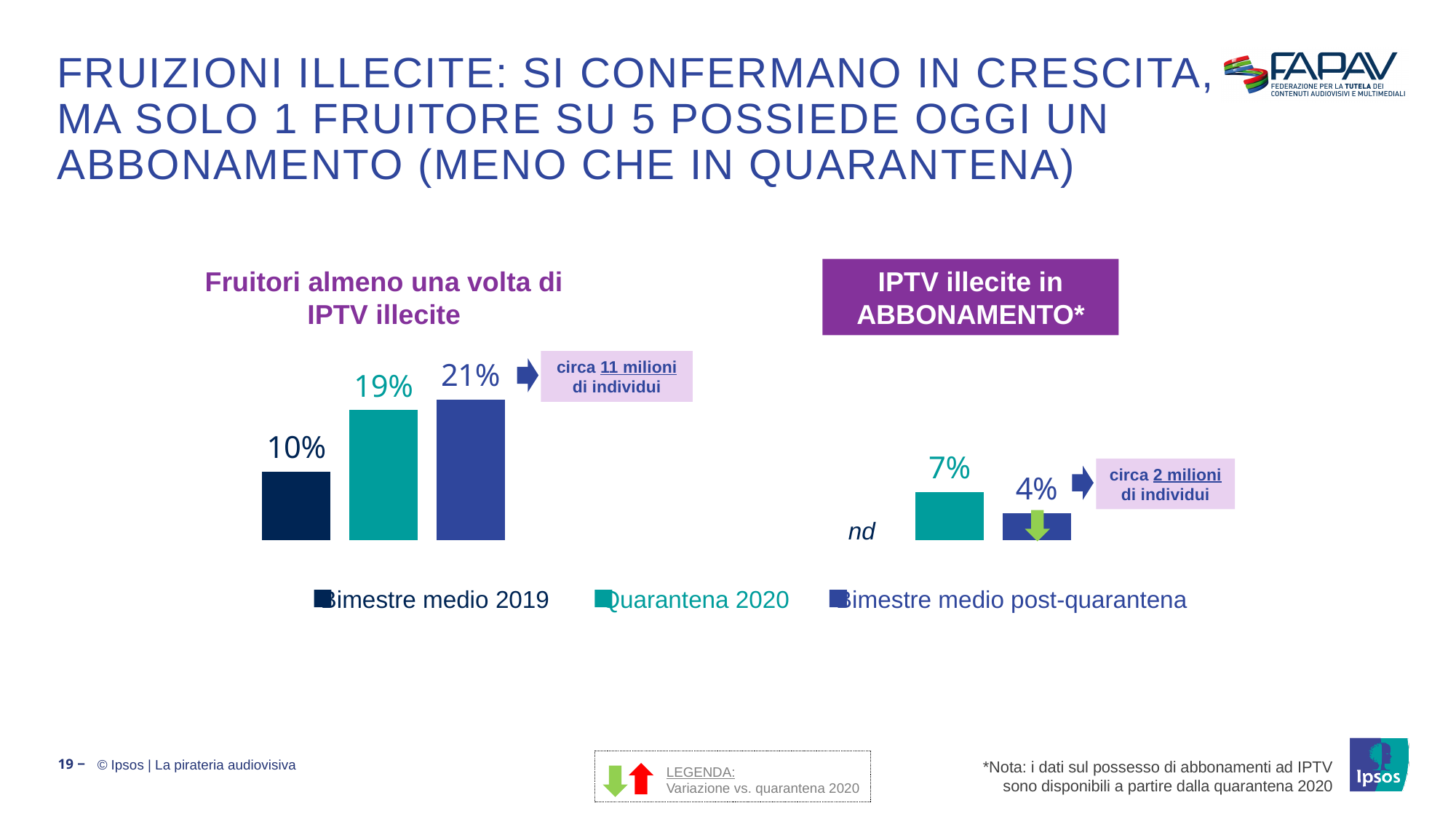
In the chart 'Fruitori almeno una volta di IPTV illecite', what is the value for Bimestre medio post-quarantena? 21% In the chart 'IPTV illecite in ABBONAMENTO*', what is the difference between Quarantena 2020 and Bimestre medio post-quarantena? 3% In the chart 'IPTV illecite in ABBONAMENTO*', what is the value for Quarantena 2020? 7% In the chart 'Fruitori almeno una volta di IPTV illecite', which period has the lowest value? Bimestre medio 2019 In the chart 'Fruitori almeno una volta di IPTV illecite', which period has the highest value? Bimestre medio post-quarantena In the chart 'IPTV illecite in ABBONAMENTO*', what is the value for Bimestre medio post-quarantena? 4% In the chart 'IPTV illecite in ABBONAMENTO*', which is larger: Quarantena 2020 or Bimestre medio post-quarantena? Quarantena 2020 In the chart 'Fruitori almeno una volta di IPTV illecite', what is the difference between Bimestre medio post-quarantena and Bimestre medio 2019? 11% In the chart 'Fruitori almeno una volta di IPTV illecite', what is the value for Bimestre medio 2019? 10% What kind of chart is 'Fruitori almeno una volta di IPTV illecite'? Bar chart In the chart 'Fruitori almeno una volta di IPTV illecite', what is the value for Quarantena 2020? 19% How many series does the legend list? 3